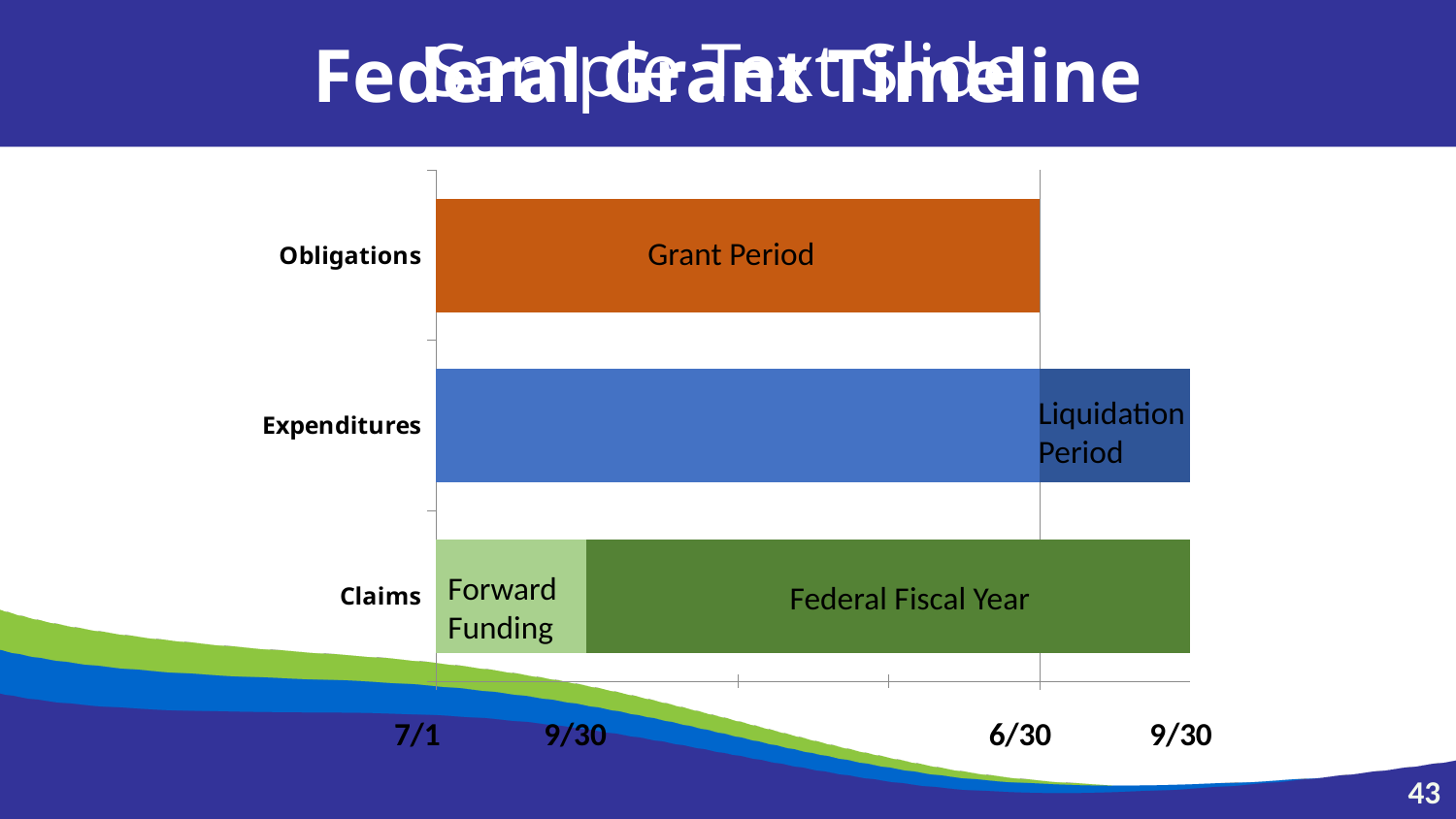
Which bar extends further to the right, Expenditures or Obligations? Expenditures At which axis date does the Grant Period bar for Obligations end? 6/30 What label is printed on the Obligations bar? Grant Period At which axis date does the Federal Fiscal Year segment of the Claims bar end? 9/30 At which axis date do all three bars in the chart begin? 7/1 Which category has the shortest bar in the chart? Obligations What colour is the Obligations bar? orange At which axis date does the Forward Funding segment of the Claims bar end? 9/30 How many categories are listed on the vertical axis of the chart? 3 At which axis date does the Liquidation Period segment of the Expenditures bar begin? 6/30 What kind of chart is shown on the slide? bar chart How many labelled segments make up the Claims bar? 2